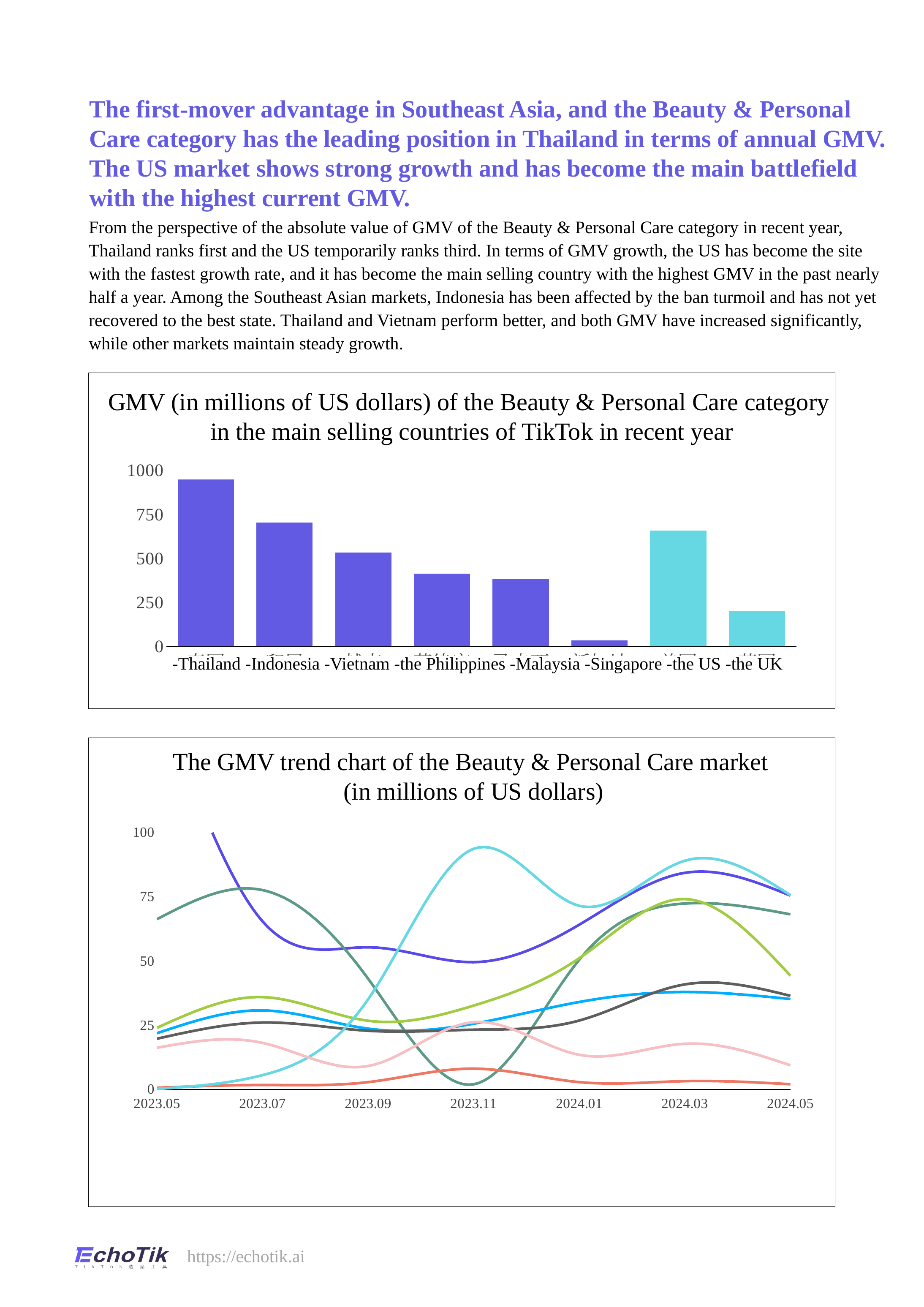
What type of chart is the top chart, 'GMV (in millions of US dollars) of the Beauty & Personal Care category in the main selling countries of TikTok in recent year'? bar chart In the top bar chart, is the value for Thailand greater or less than 750? greater In the top bar chart, which has a larger GMV, Vietnam or the US? the US In the bottom line chart, what are the first and last dates labelled on the x axis? 2023.05 and 2024.05 What type of chart is the bottom chart, 'The GMV trend chart of the Beauty & Personal Care market'? line chart In the top bar chart, which country has the highest GMV? Thailand In the top bar chart, is the value for Indonesia greater or less than 750? less In the top bar chart, is the value for the US greater or less than 500? greater In the top bar chart, which has a larger GMV, Malaysia or the UK? Malaysia How many countries are shown in the top bar chart? 8 In the top bar chart, which country has the lowest GMV? Singapore